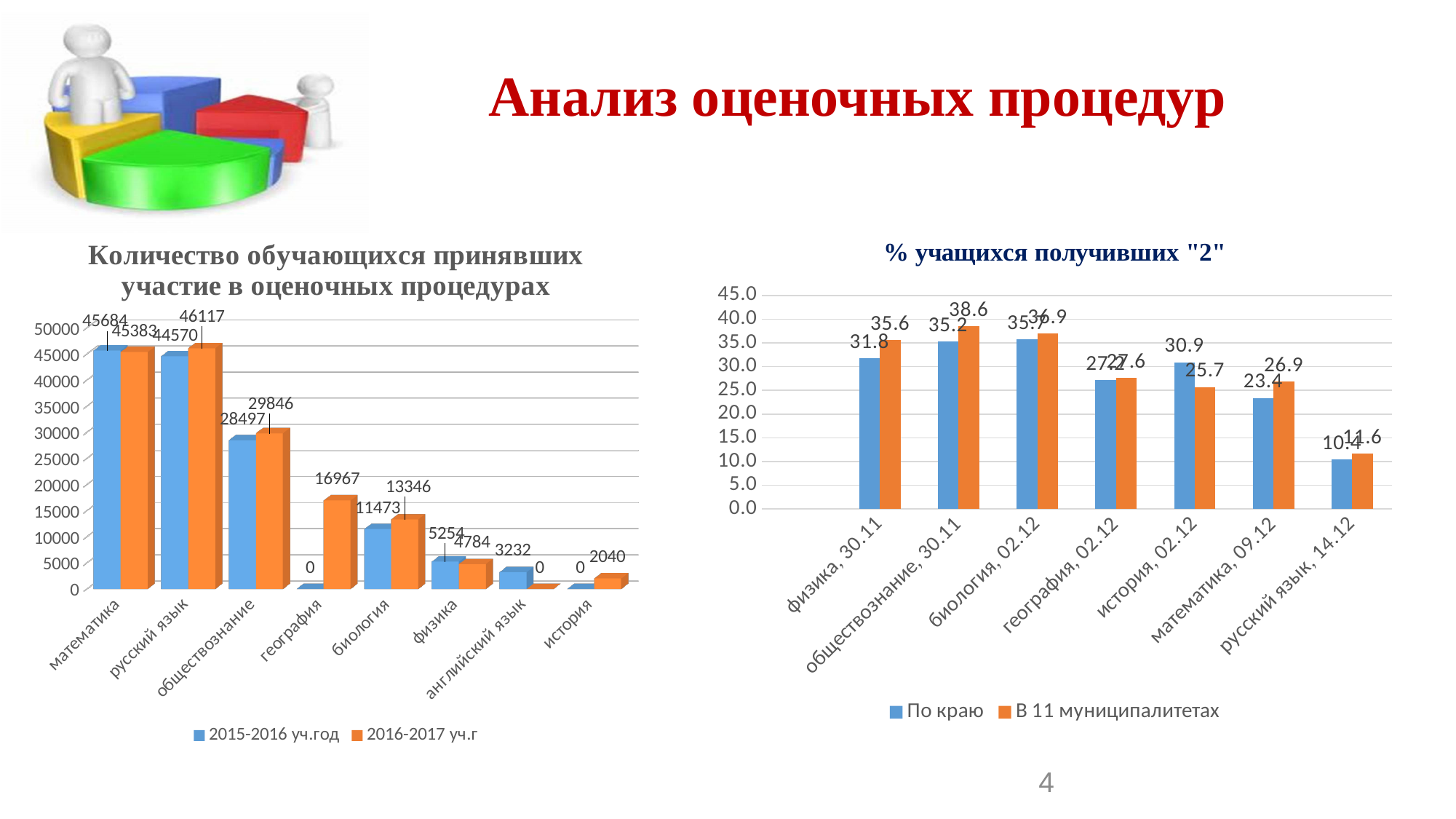
In the right chart "% учащихся получивших "2"", which category has the lowest value in the series В 11 муниципалитетах? русский язык, 14.12 In the right chart "% учащихся получивших "2"", what is the value for обществознание, 30.11 in the series В 11 муниципалитетах? 38.6 In the right chart "% учащихся получивших "2"", what is the difference between the В 11 муниципалитетах and По краю values for математика, 09.12? 3.5 How many subject categories are shown on the x axis of the left chart "Количество обучающихся принявших участие в оценочных процедурах"? 8 How many series does the legend of the left chart "Количество обучающихся принявших участие в оценочных процедурах" list? 2 In the left chart "Количество обучающихся принявших участие в оценочных процедурах", which subject has the highest value for 2016-2017 уч.г? русский язык In the left chart "Количество обучающихся принявших участие в оценочных процедурах", what is the difference between the 2016-2017 уч.г and 2015-2016 уч.год values for русский язык? 1547 In the left chart "Количество обучающихся принявших участие в оценочных процедурах", what is the value for математика in 2015-2016 уч.год? 45684 In the right chart "% учащихся получивших "2"", what is the value for история, 02.12 in the series По краю? 30.9 In the left chart "Количество обучающихся принявших участие в оценочных процедурах", what is the value for география in 2016-2017 уч.г? 16967 In the left chart "Количество обучающихся принявших участие в оценочных процедурах", which series has the larger value for физика: 2015-2016 уч.год or 2016-2017 уч.г? 2015-2016 уч.год What kind of chart is the right chart "% учащихся получивших "2""? bar chart